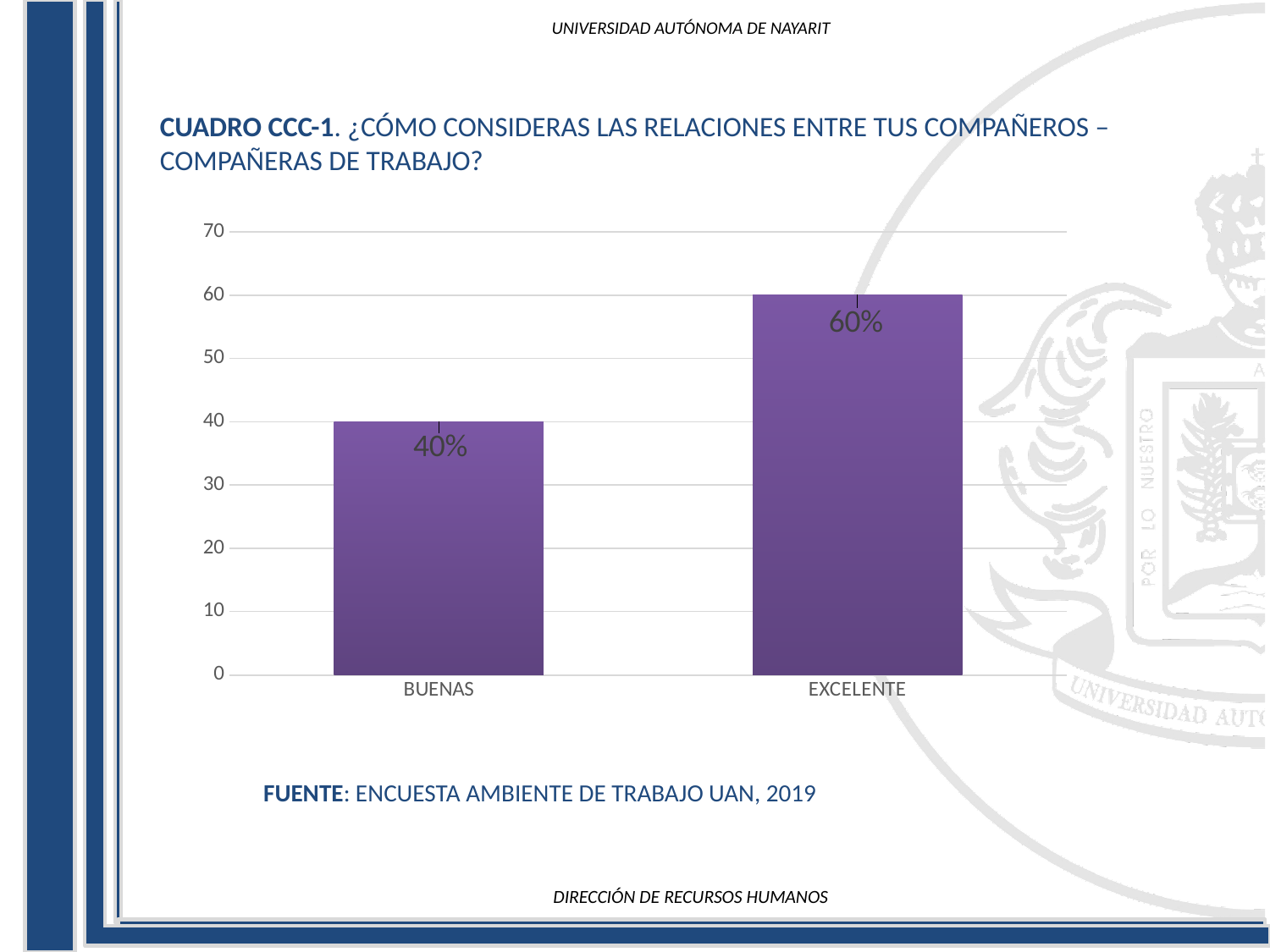
Which is larger, the value for BUENAS or the value for EXCELENTE? EXCELENTE What is the difference between the values for EXCELENTE and BUENAS? 20% Which category has the highest value? EXCELENTE Which category has the lowest value? BUENAS What is the value for BUENAS? 40% Is the value for BUENAS greater or less than 50? less Is the value for EXCELENTE greater or less than 50? greater What is the value for EXCELENTE? 60% What is the maximum value shown on the y axis? 70 What kind of chart is shown on the slide? bar chart How many categories are shown on the x axis? 2 What source is cited below the chart? ENCUESTA AMBIENTE DE TRABAJO UAN, 2019